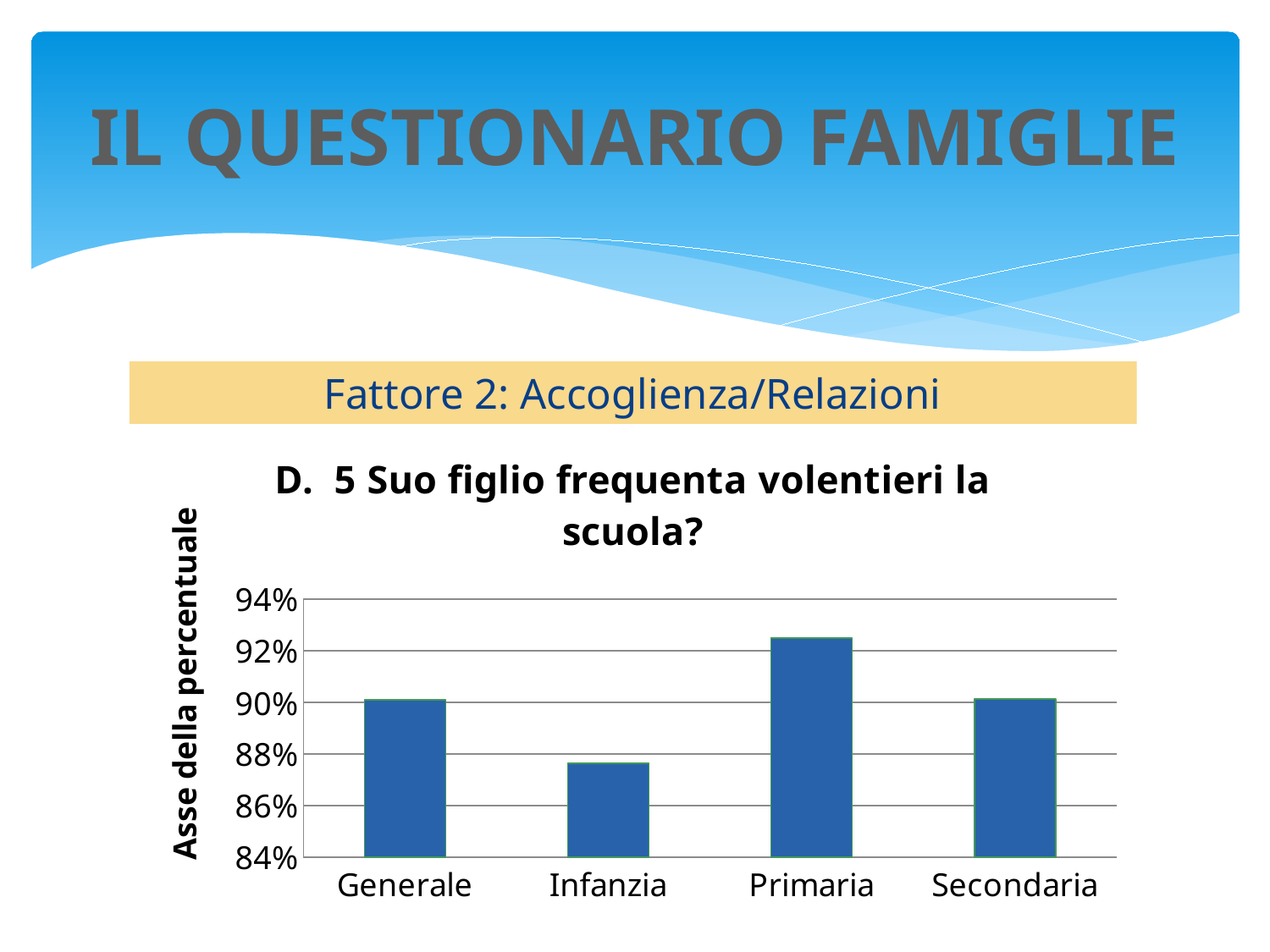
How many categories are shown on the x axis of the chart? 4 Which category has the highest value in the chart? Primaria Is the value for Primaria greater or less than 92%? greater Is the value for Secondaria greater or less than 92%? less Is the value for Infanzia greater or less than 88%? less What kind of chart is shown on the slide? bar chart Which category has the lowest value in the chart? Infanzia Which is larger, the value for Primaria or the value for Infanzia? Primaria What is the title of the chart? D. 5 Suo figlio frequenta volentieri la scuola? Which is larger, the value for Generale or the value for Infanzia? Generale What is the label of the vertical axis of the chart? Asse della percentuale